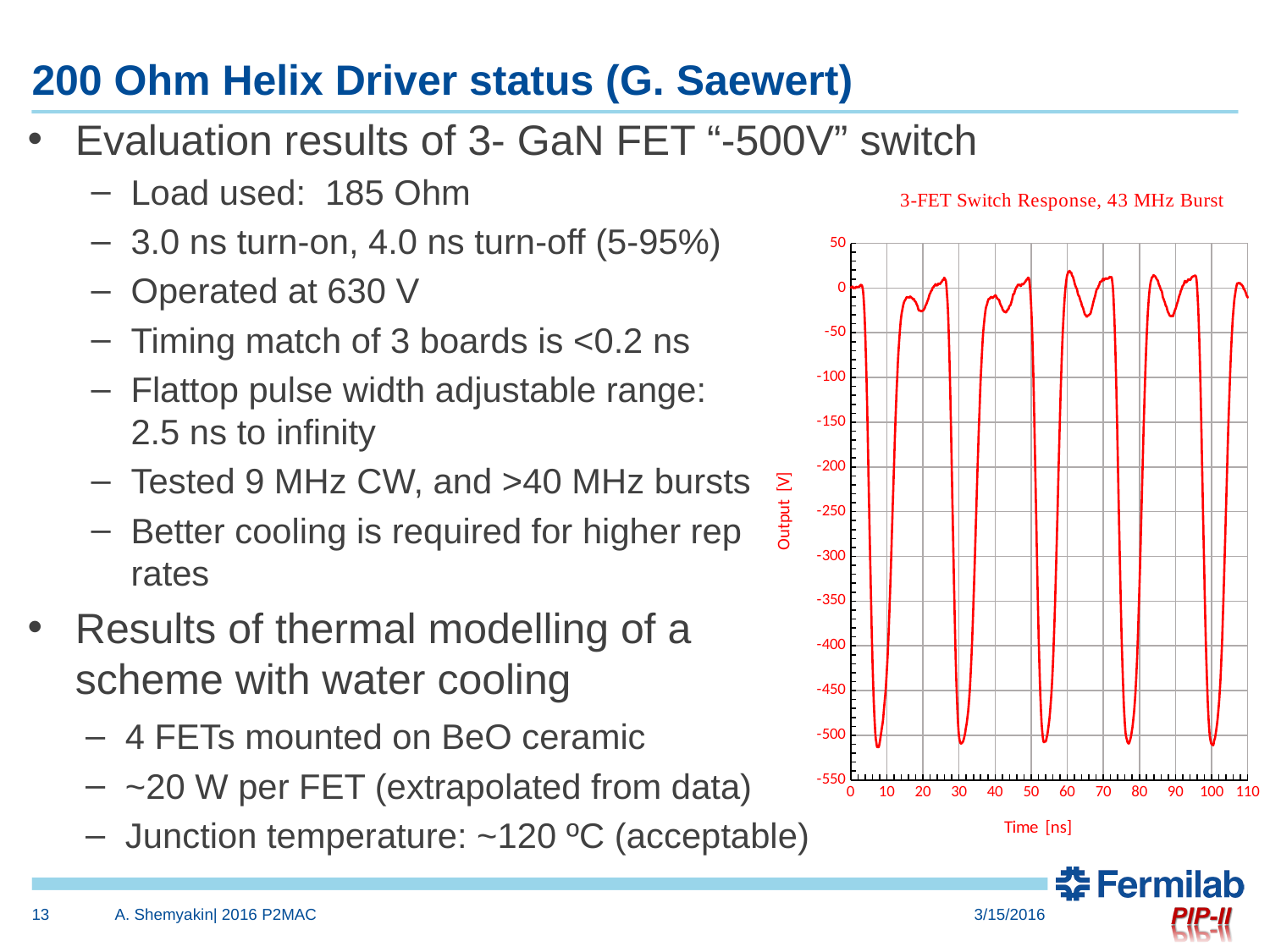
What is the label of the x axis of the chart? Time [ns] Is the lowest value reached by the trace greater or less than -450? less Is the value of the trace at 8 ns greater or less than -400? less What kind of chart is shown on the slide? line chart How many negative pulses (dips) does the trace show in the chart? 5 What is the title of the chart? 3-FET Switch Response, 43 MHz Burst Is the value of the trace at 100 ns greater or less than -300? less How many lines are plotted in the chart? 1